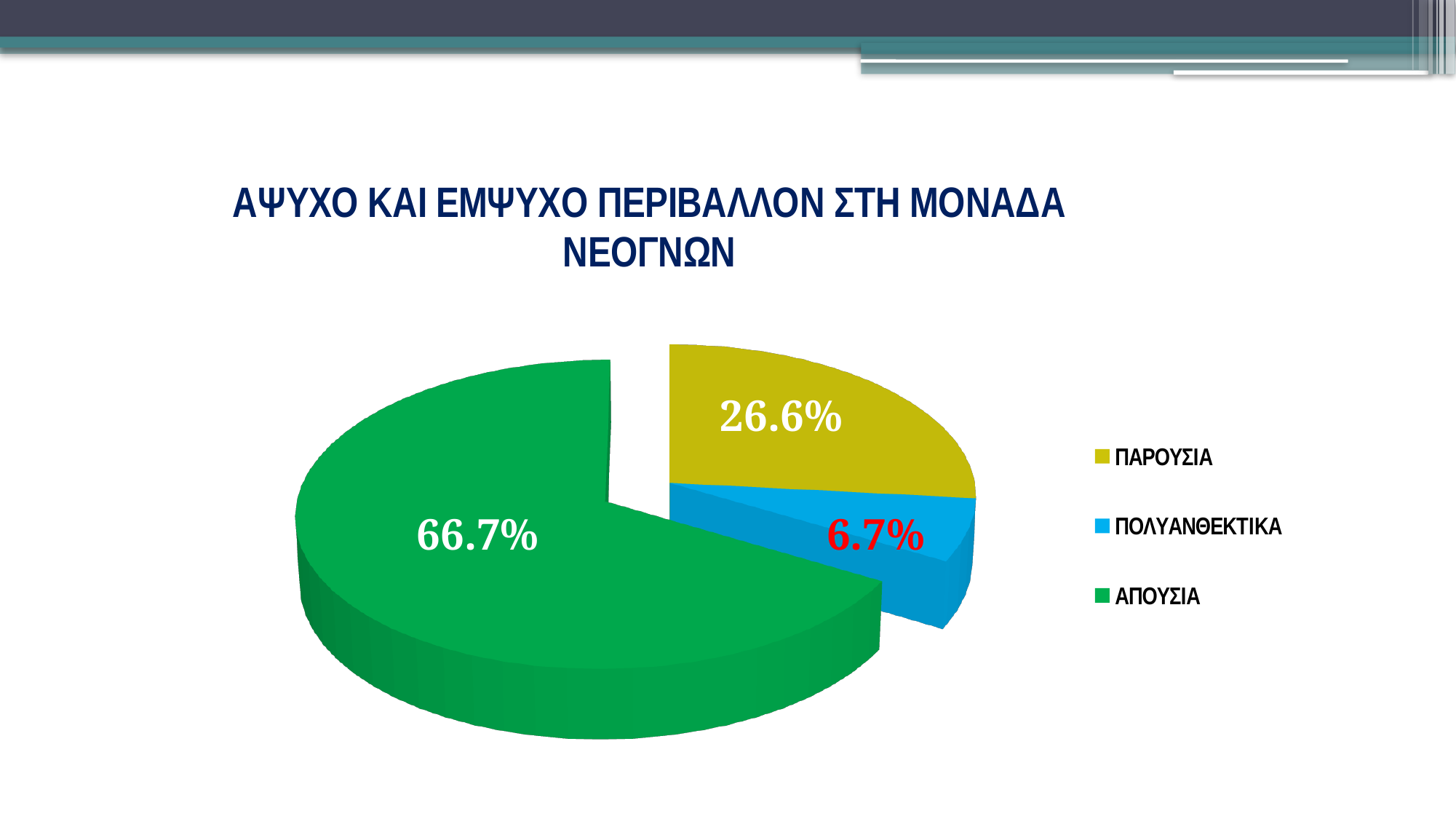
What is the value for ΠΟΛΥΑΝΘΕΚΤΙΚΑ? 6.7% What is the difference between the values for ΑΠΟΥΣΙΑ and ΠΑΡΟΥΣΙΑ? 40.1% What colour is the slice for ΠΟΛΥΑΝΘΕΚΤΙΚΑ? Blue Which category has the largest share of the pie? ΑΠΟΥΣΙΑ What is the value for ΠΑΡΟΥΣΙΑ? 26.6% Which is larger, the value for ΠΑΡΟΥΣΙΑ or the value for ΠΟΛΥΑΝΘΕΚΤΙΚΑ? ΠΑΡΟΥΣΙΑ What is the value for ΑΠΟΥΣΙΑ? 66.7% How many slices does the pie chart have? 3 What is the title of the chart? ΑΨΥΧΟ ΚΑΙ ΕΜΨΥΧΟ ΠΕΡΙΒΑΛΛΟΝ ΣΤΗ ΜΟΝΑΔΑ ΝΕΟΓΝΩΝ What is the difference between the values for ΠΑΡΟΥΣΙΑ and ΠΟΛΥΑΝΘΕΚΤΙΚΑ? 19.9% Which category has the smallest share of the pie? ΠΟΛΥΑΝΘΕΚΤΙΚΑ What type of chart is shown on the slide? Pie chart